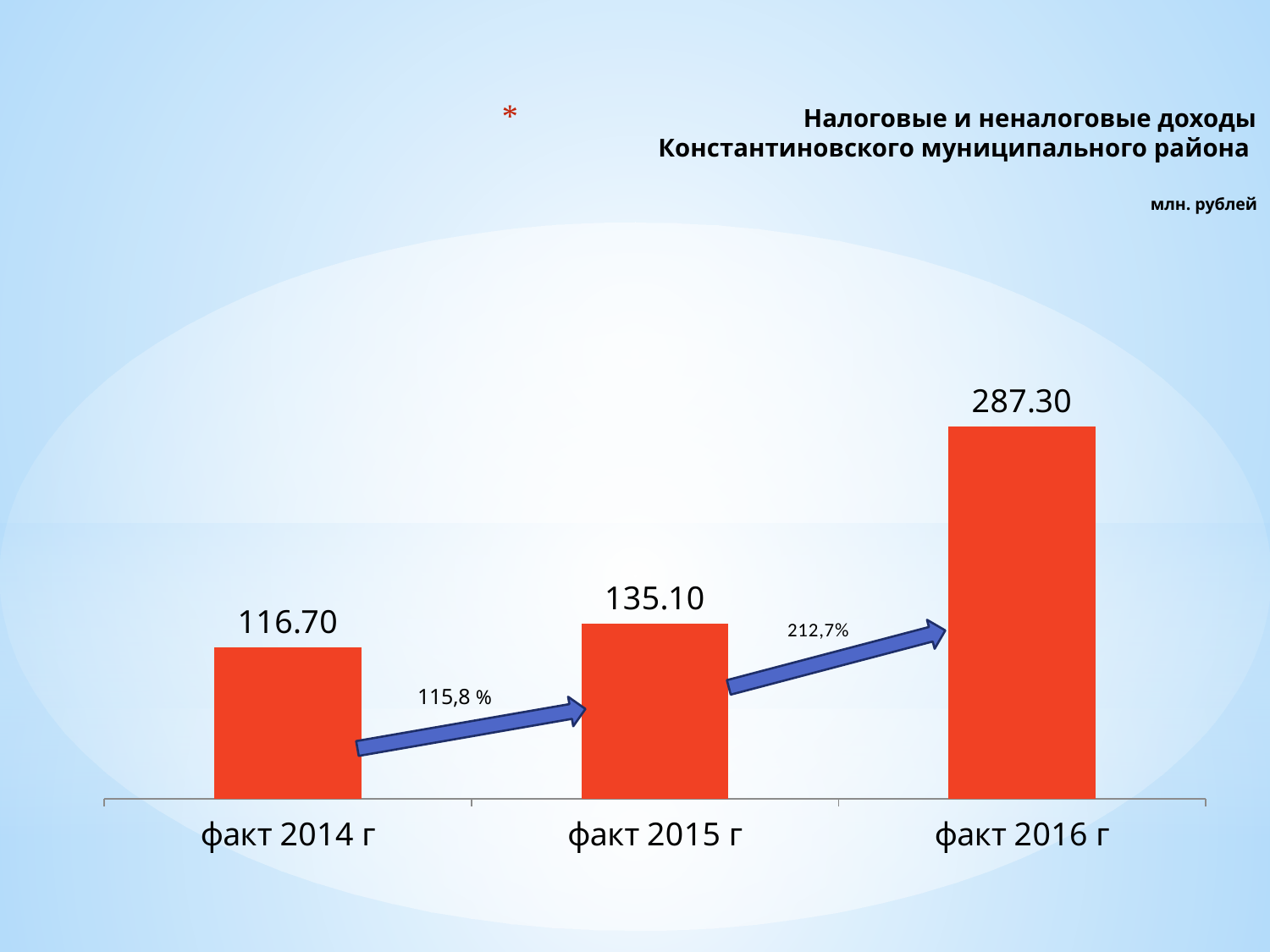
Which is larger, the value for факт 2014 г or факт 2015 г? факт 2015 г What is the value for факт 2015 г? 135.10 Which category has the highest value? факт 2016 г Which category has the lowest value? факт 2014 г What is the difference between the values for факт 2015 г and факт 2014 г? 18.40 What kind of chart is shown on the slide? bar chart What is the difference between the values for факт 2016 г and факт 2015 г? 152.20 What is the value for факт 2014 г? 116.70 Do the values rise or fall from факт 2014 г to факт 2016 г? rise What is the value for факт 2016 г? 287.30 How many categories are shown on the chart? 3 What unit of measurement is stated for the chart? млн. рублей